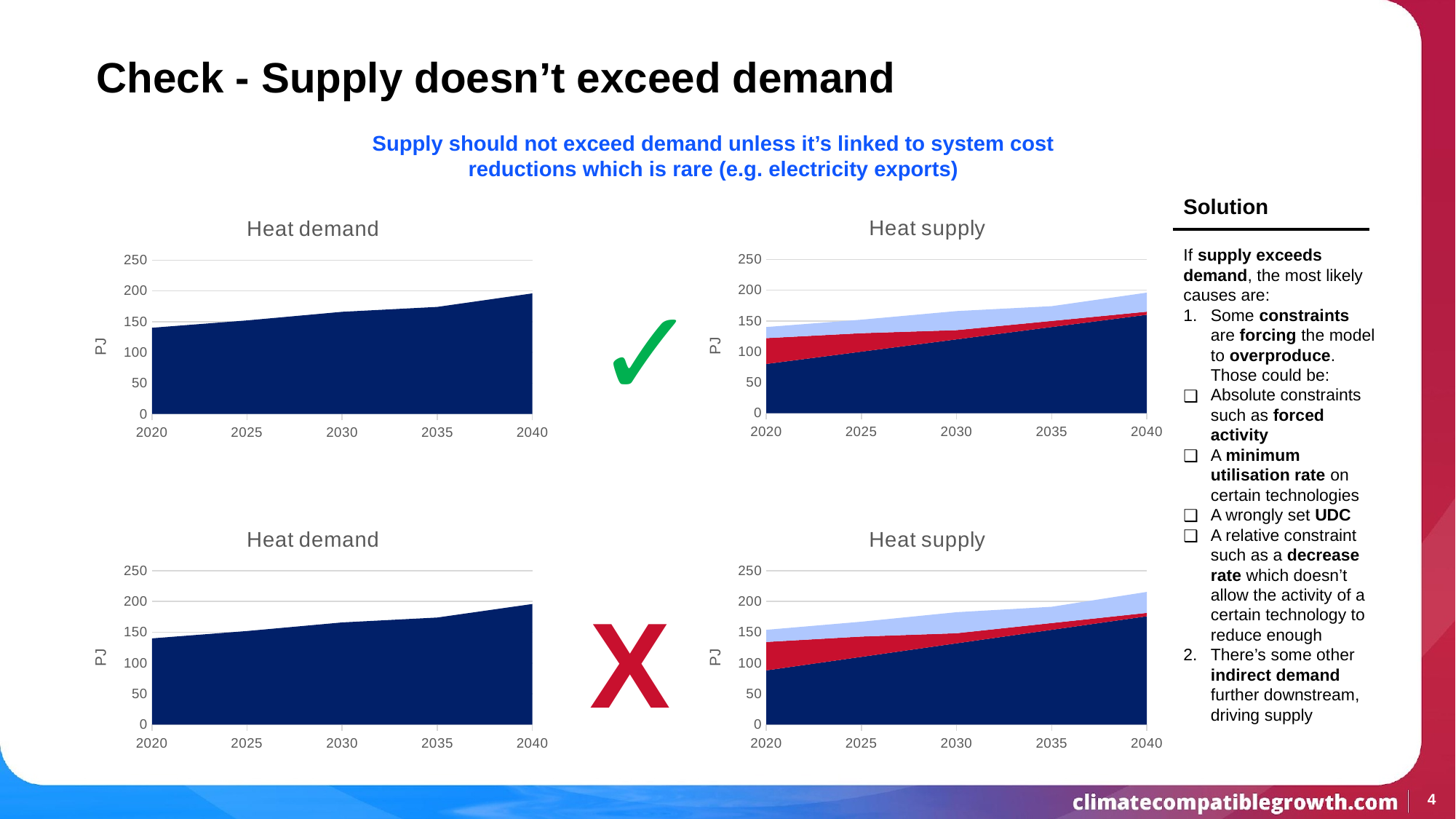
What is the title of the bottom-right chart? Heat supply How many coloured series are stacked in the top-right 'Heat supply' chart? 3 In the top-right 'Heat supply' chart, is the dark blue series value for 2020 greater or less than 100? less In the top-left 'Heat demand' chart, do the values rise or fall from 2020 to 2040? rise In the top-left 'Heat demand' chart, is the value for 2020 greater or less than 150? less In the bottom-right 'Heat supply' chart, is the total value for 2040 greater or less than 200? greater In the bottom-right 'Heat supply' chart, does the total rise or fall from 2020 to 2040? rise What kind of chart is the top-left 'Heat demand' chart? area chart What is the y-axis label on the top-right 'Heat supply' chart? PJ How many year labels are shown on the x axis of the bottom-left 'Heat demand' chart? 5